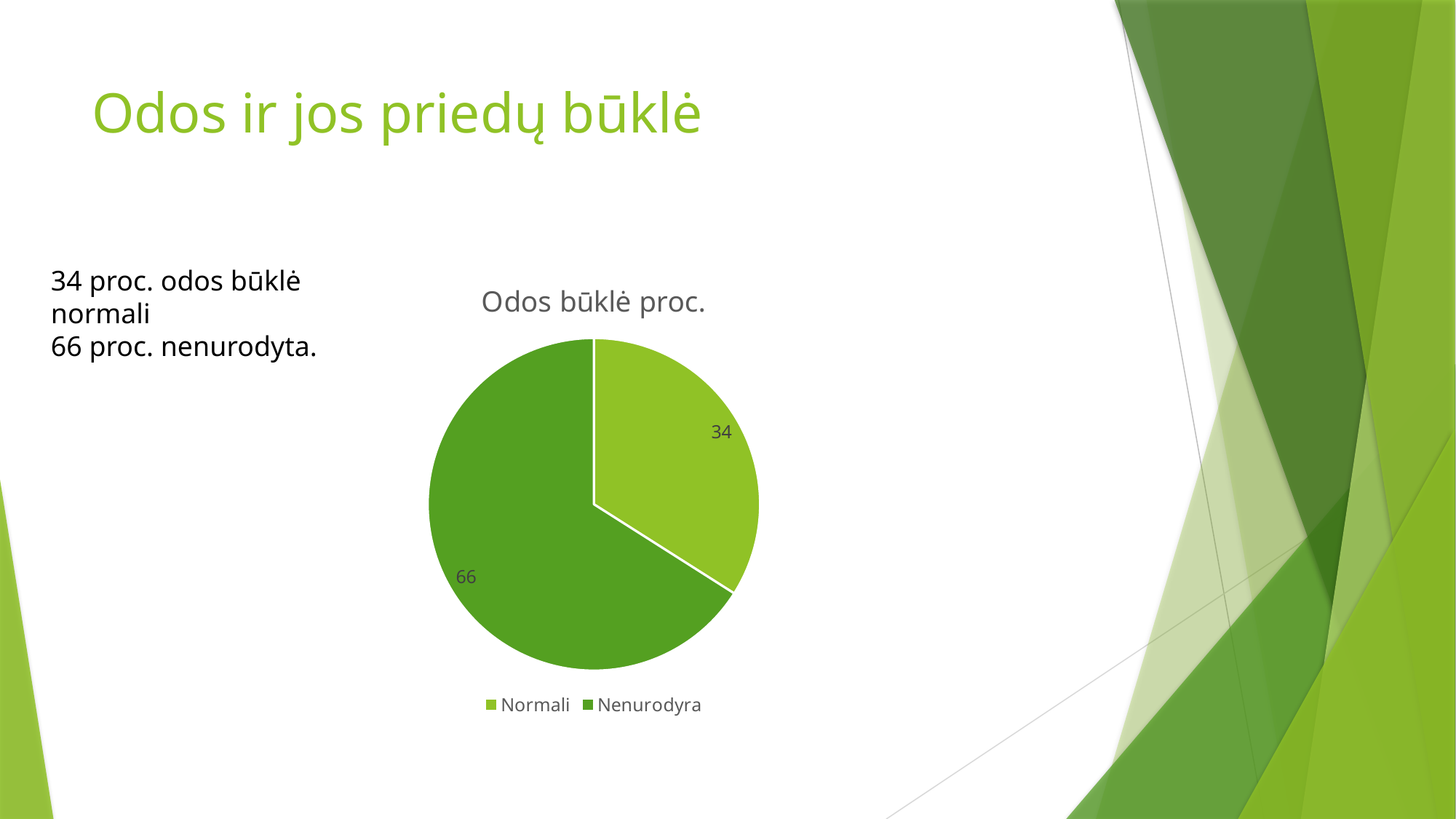
What share of the pie does the Nenurodyra slice represent? 66% How many slices does the pie chart have? 2 Which category has the smallest slice in the pie chart? Normali Which is larger, the value for Normali or the value for Nenurodyra? Nenurodyra What kind of chart is shown on the slide? Pie chart What is the value for Normali in the pie chart? 34 What is the value for Nenurodyra in the pie chart? 66 What is the difference between the values for Nenurodyra and Normali? 32 What share of the pie does the Normali slice represent? 34% What is the title of the pie chart? Odos būklė proc. Which legend entry is shown in the darker green colour? Nenurodyra Which category has the largest slice in the pie chart? Nenurodyra